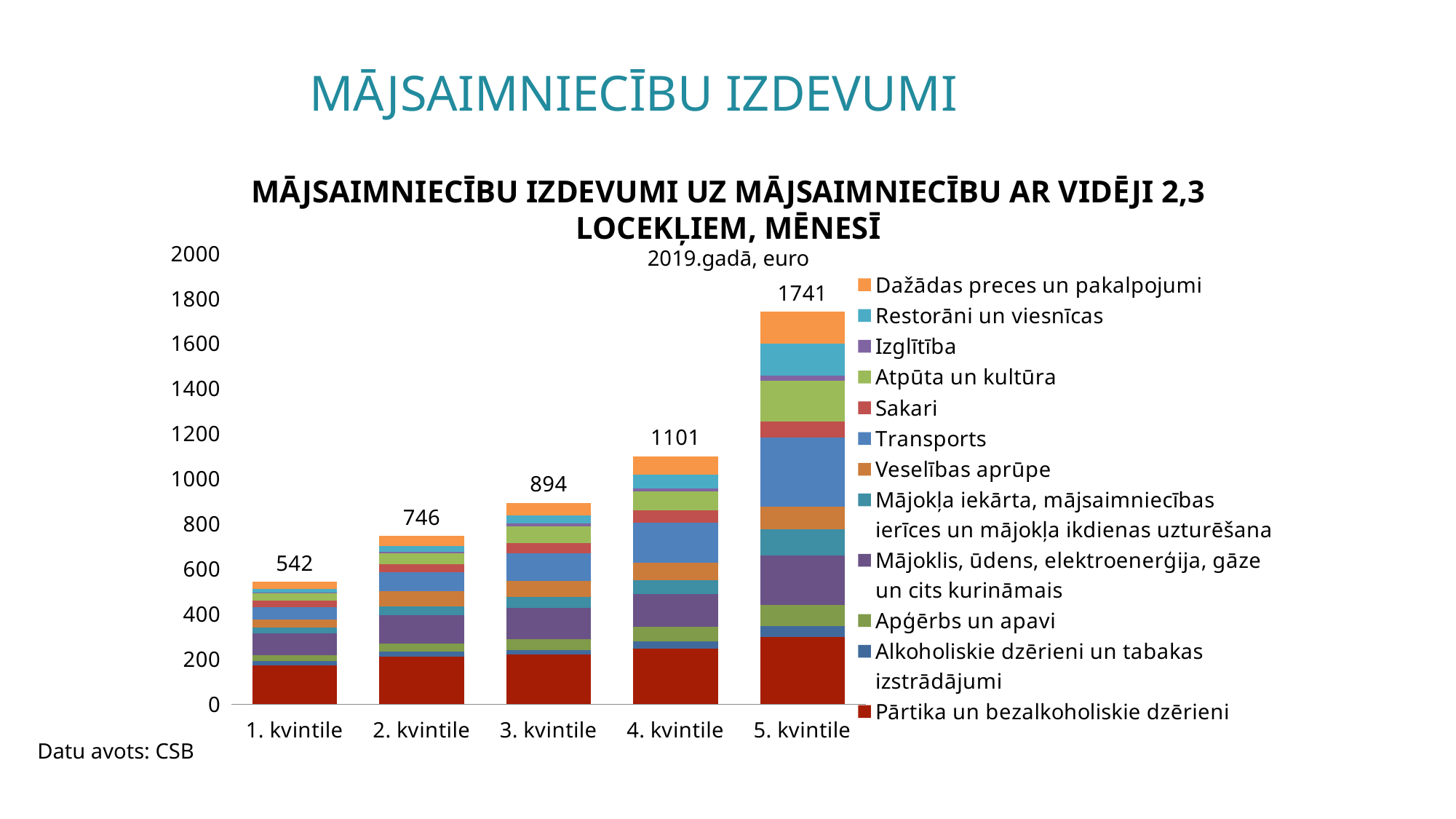
Do the total expenditures rise or fall from 1. kvintile to 5. kvintile? Rise What is the difference between the total expenditure of 3. kvintile and 2. kvintile? 148 Is the value of the Pārtika un bezalkoholiskie dzērieni segment for 5. kvintile greater or less than 200? greater How many quintile categories are shown on the x axis? 5 How many expenditure categories does the legend list? 12 Which quintile has the highest total expenditure? 5. kvintile Which has a larger total expenditure, 2. kvintile or 3. kvintile? 3. kvintile What is the total household expenditure shown for 1. kvintile? 542 Which quintile has the lowest total expenditure? 1. kvintile What kind of chart is shown on the slide? Stacked bar chart What is the difference between the total expenditure of 5. kvintile and 4. kvintile? 640 What is the total household expenditure shown for 4. kvintile? 1101